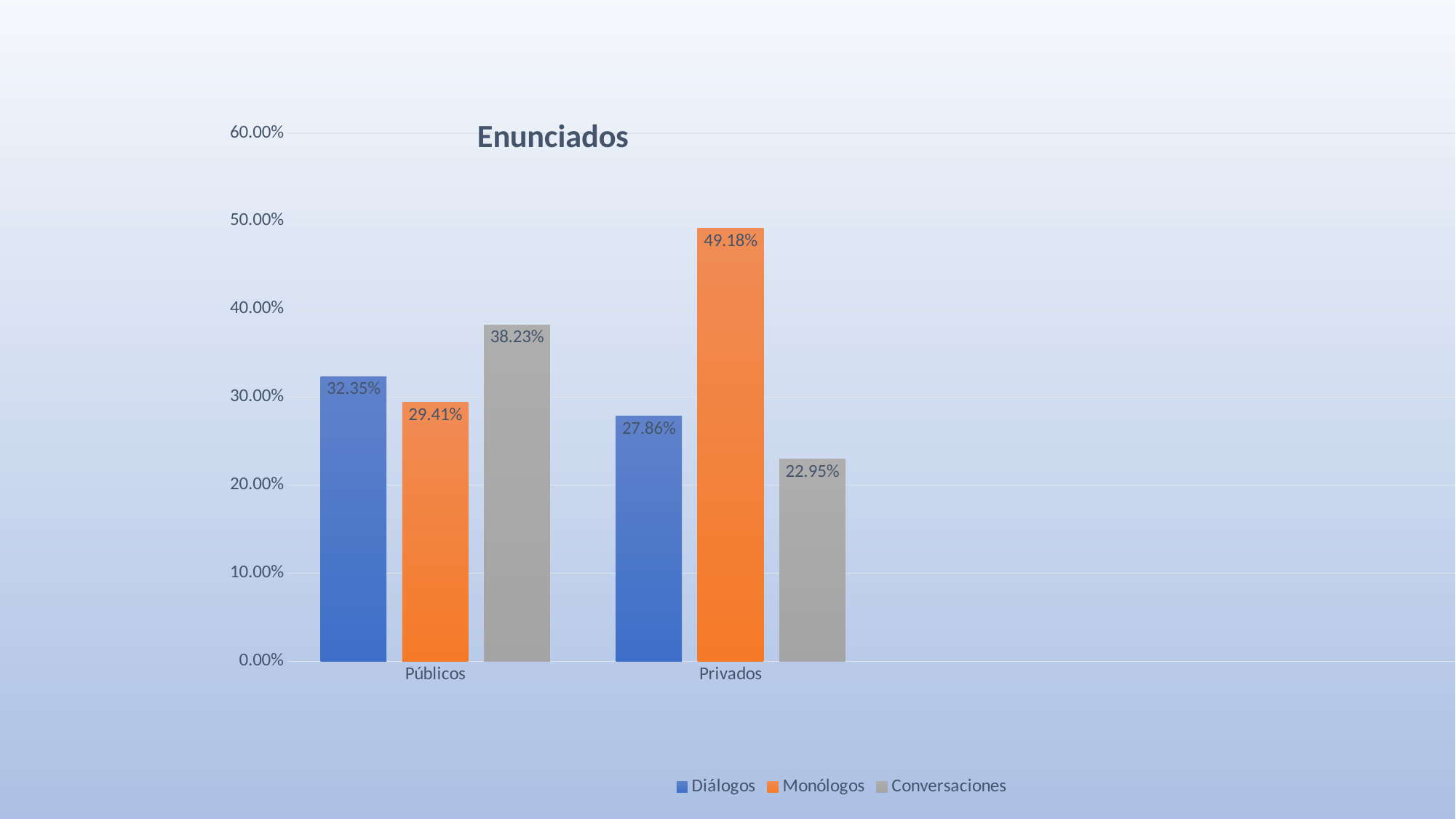
What kind of chart is shown on the slide? Bar chart What is the value for Conversaciones in the Públicos category? 38.23% Which is larger: Diálogos for Públicos or Diálogos for Privados? Públicos How many series does the legend list? 3 What is the title of the chart? Enunciados Which series has the lowest value in the Públicos category? Monólogos What is the value for Diálogos in the Públicos category? 32.35% How many categories are shown on the x axis? 2 What is the value for Conversaciones in the Privados category? 22.95% What is the difference between the Monólogos values for Privados and Públicos? 19.77% Which series has the highest value in the Privados category? Monólogos What is the value for Monólogos in the Privados category? 49.18%